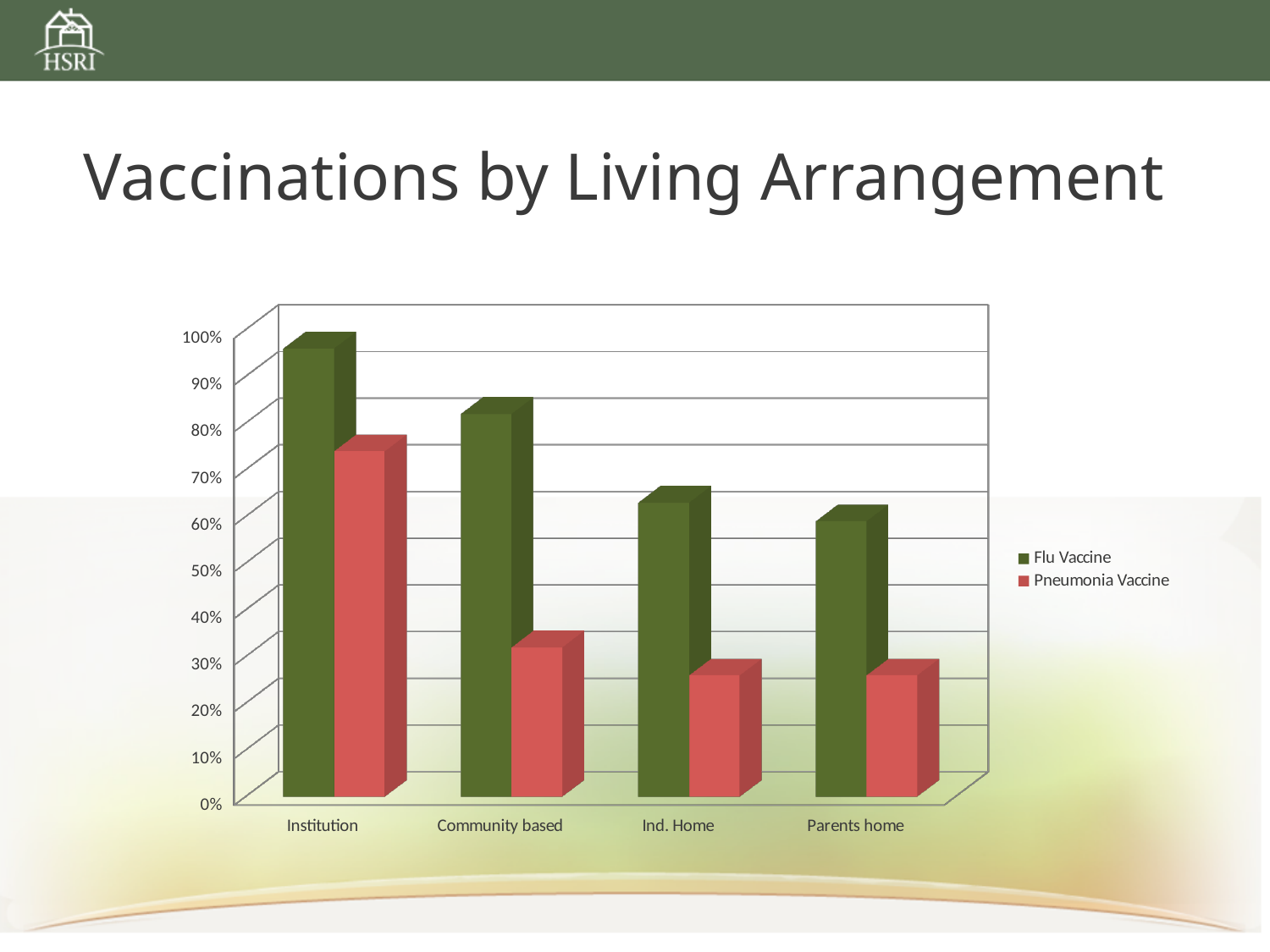
Which living arrangement has the highest Flu Vaccine value? Institution Is the Pneumonia Vaccine value for Community based greater or less than 40%? less What is the title of the chart? Vaccinations by Living Arrangement How many living arrangement categories are shown on the x axis? 4 Do the Flu Vaccine values rise or fall moving from Institution to Parents home along the x axis? Fall Which living arrangement has the lowest Flu Vaccine value? Parents home What kind of chart is shown on the slide? Bar chart For Community based, which is larger: the Flu Vaccine value or the Pneumonia Vaccine value? Flu Vaccine Is the Pneumonia Vaccine value for Institution greater or less than 60%? greater How many series does the legend list? 2 Is the Flu Vaccine value for Institution greater or less than 90%? greater Which living arrangement has the highest Pneumonia Vaccine value? Institution